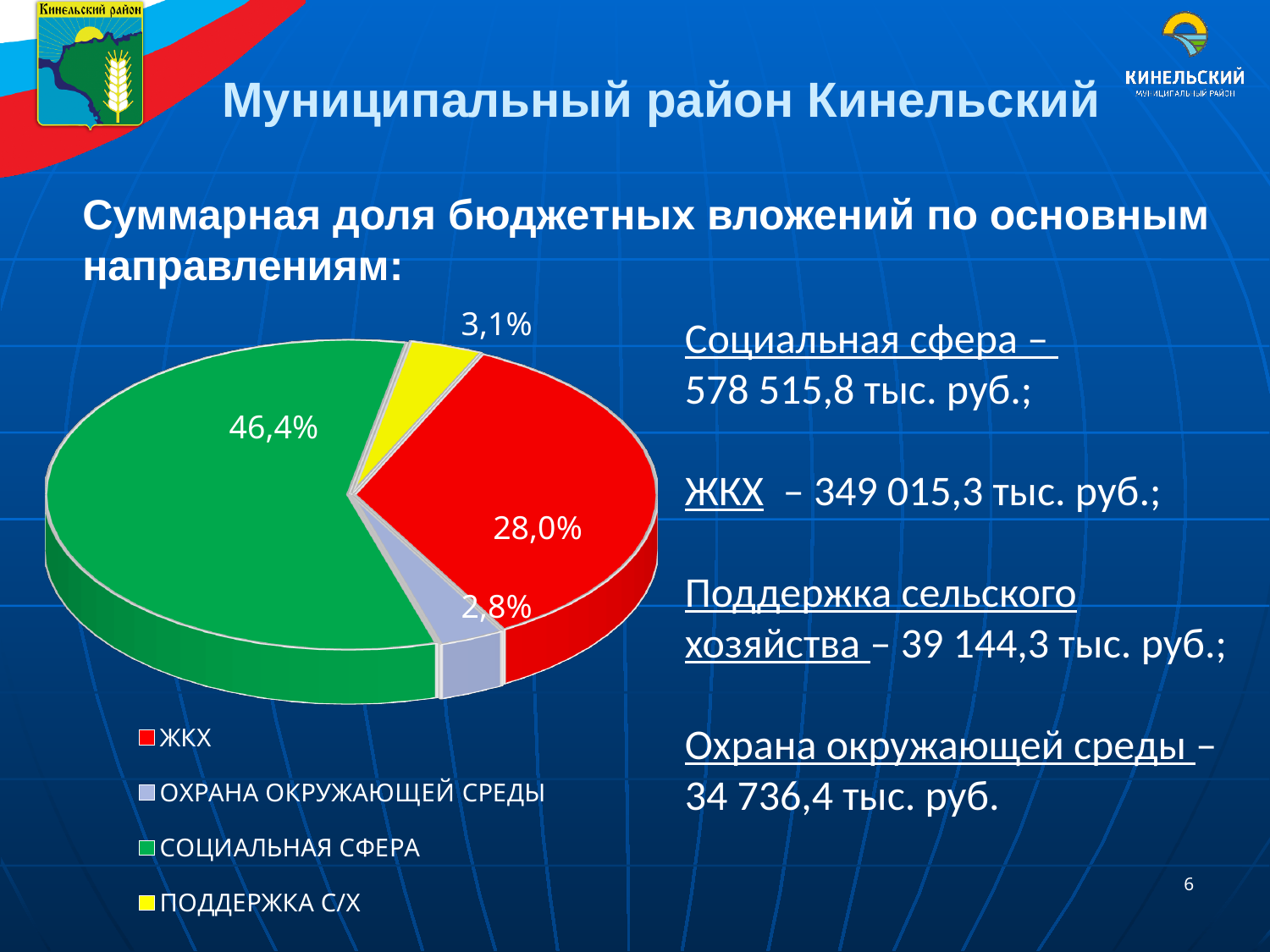
What type of chart is shown on the slide? Pie chart How many entries does the legend of the pie chart list? 4 Which category has the largest share in the pie chart? СОЦИАЛЬНАЯ СФЕРА What colour is the ЖКХ slice in the pie chart? Red What percentage does the ОХРАНА ОКРУЖАЮЩЕЙ СРЕДЫ slice show in the pie chart? 2,8% What percentage does the СОЦИАЛЬНАЯ СФЕРА slice show in the pie chart? 46,4% What percentage does the ЖКХ slice show in the pie chart? 28,0% What percentage does the ПОДДЕРЖКА С/Х slice show in the pie chart? 3,1% Which category has the smallest share in the pie chart? ОХРАНА ОКРУЖАЮЩЕЙ СРЕДЫ What is the difference in percentage points between the СОЦИАЛЬНАЯ СФЕРА and ЖКХ slices? 18,4 Which slice is larger in the pie chart: ЖКХ or ПОДДЕРЖКА С/Х? ЖКХ How many slices does the pie chart have? 4